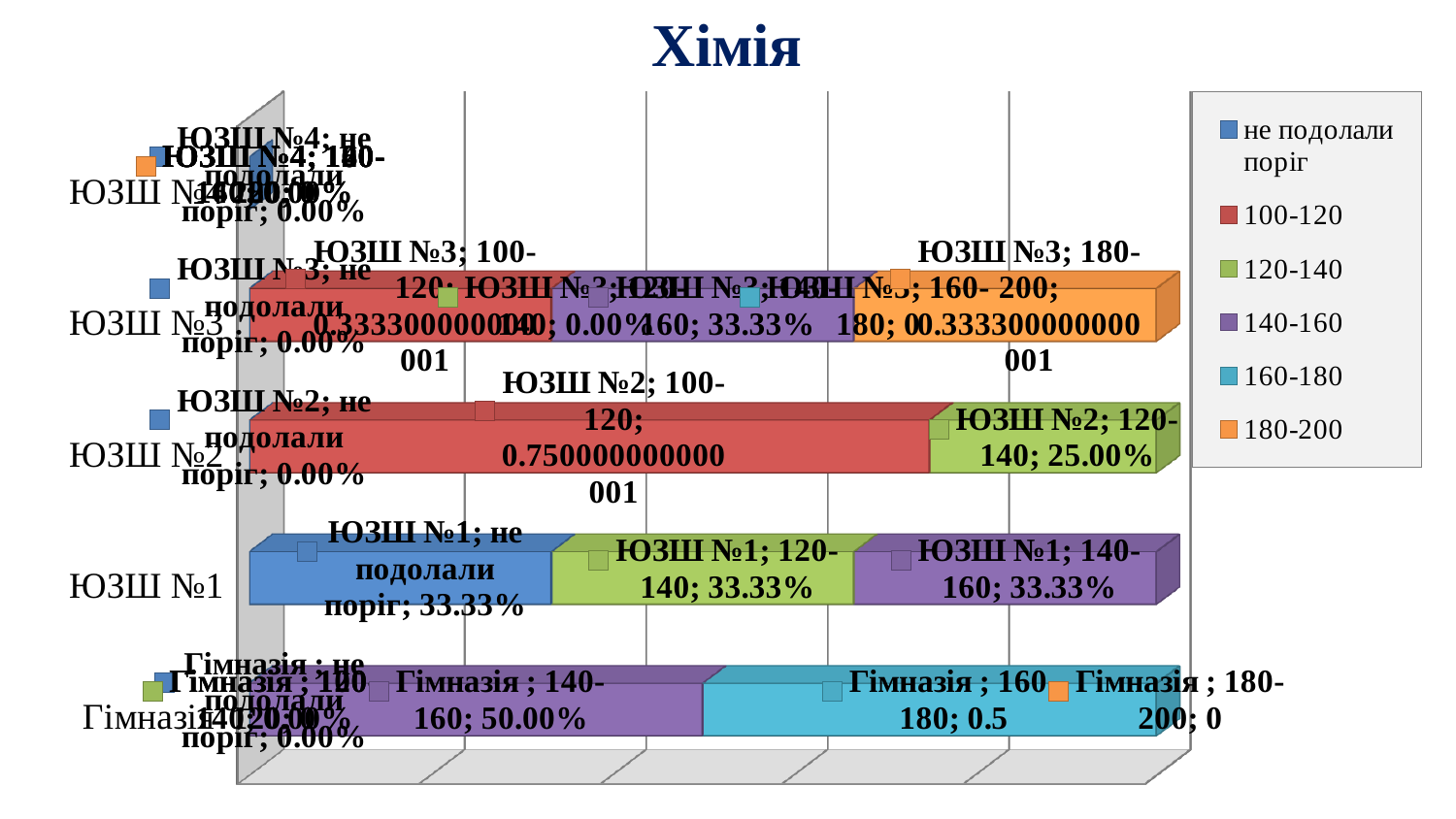
What is the value for ЮЗШ №1 in the series "не подолали поріг"? 33.33% What kind of chart is shown on the slide? Stacked bar chart What is the value for ЮЗШ №1 in the 120-140 series? 33.33% How many series does the legend list? 6 What is the value for ЮЗШ №2 in the series "не подолали поріг"? 0.00% What is the value for Гімназія in the 160-180 series? 0.5 Which legend entry is shown in orange? 180-200 How many categories (schools) are shown on the vertical axis? 5 What is the value for ЮЗШ №3 in the 140-160 series? 33.33% What is the title of the chart? Хімія What is the value for Гімназія in the 140-160 series? 50.00% What is the value for ЮЗШ №2 in the 120-140 series? 25.00%